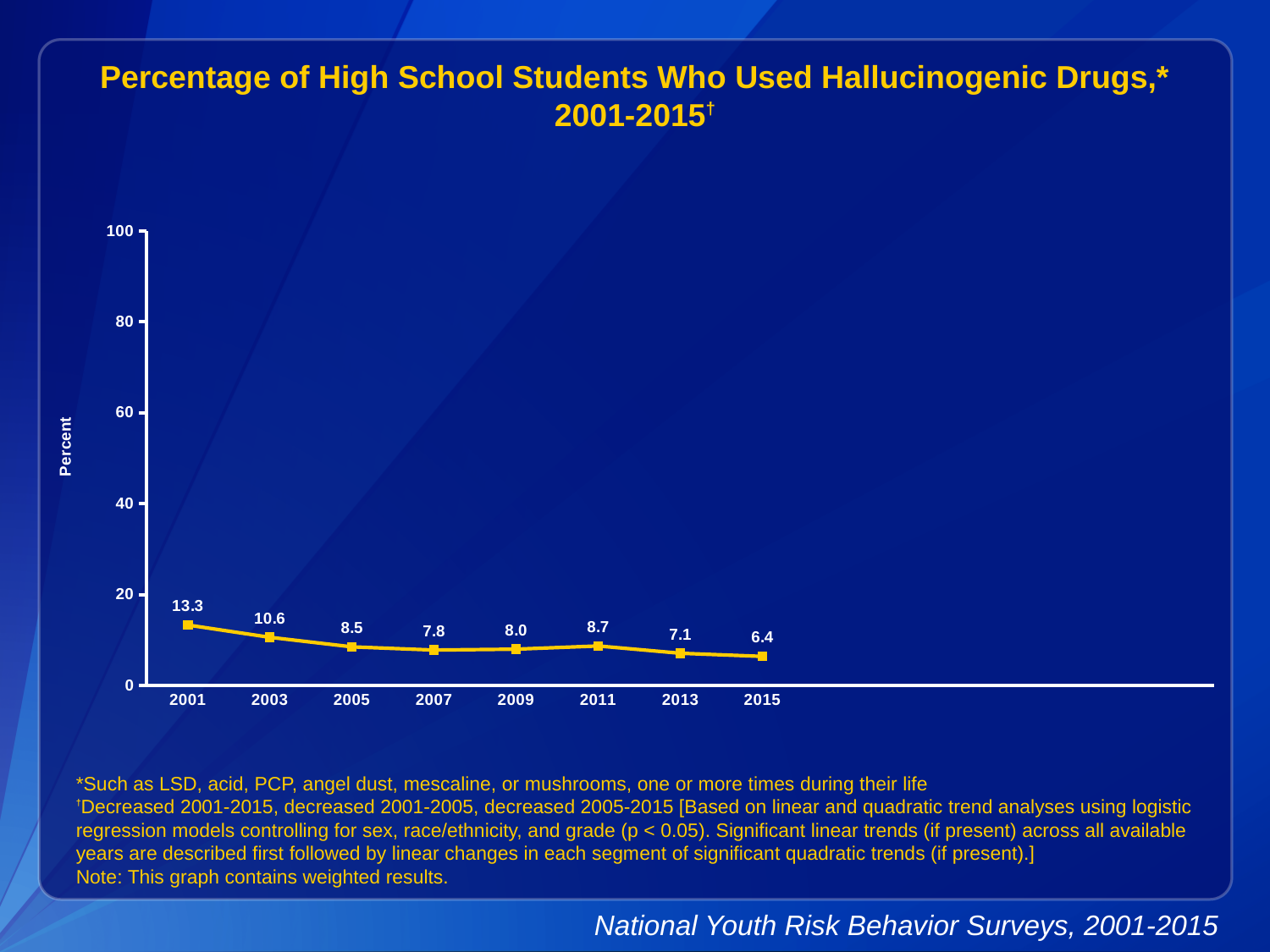
Do the values generally rise or fall from 2001 to 2015? fall What is the label on the y axis? Percent Is the value for 2003 greater or less than 20? less Which year has the lowest percentage? 2015 How many years are plotted on the x axis? 8 Which year has the highest percentage? 2001 Which is larger, the value for 2009 or the value for 2011? 2011 What is the difference between the 2001 value and the 2015 value? 6.9 What percentage of high school students used hallucinogenic drugs in 2001? 13.3 What is the value plotted for 2011? 8.7 What kind of chart is shown on the slide? line chart What is the value plotted for 2015? 6.4